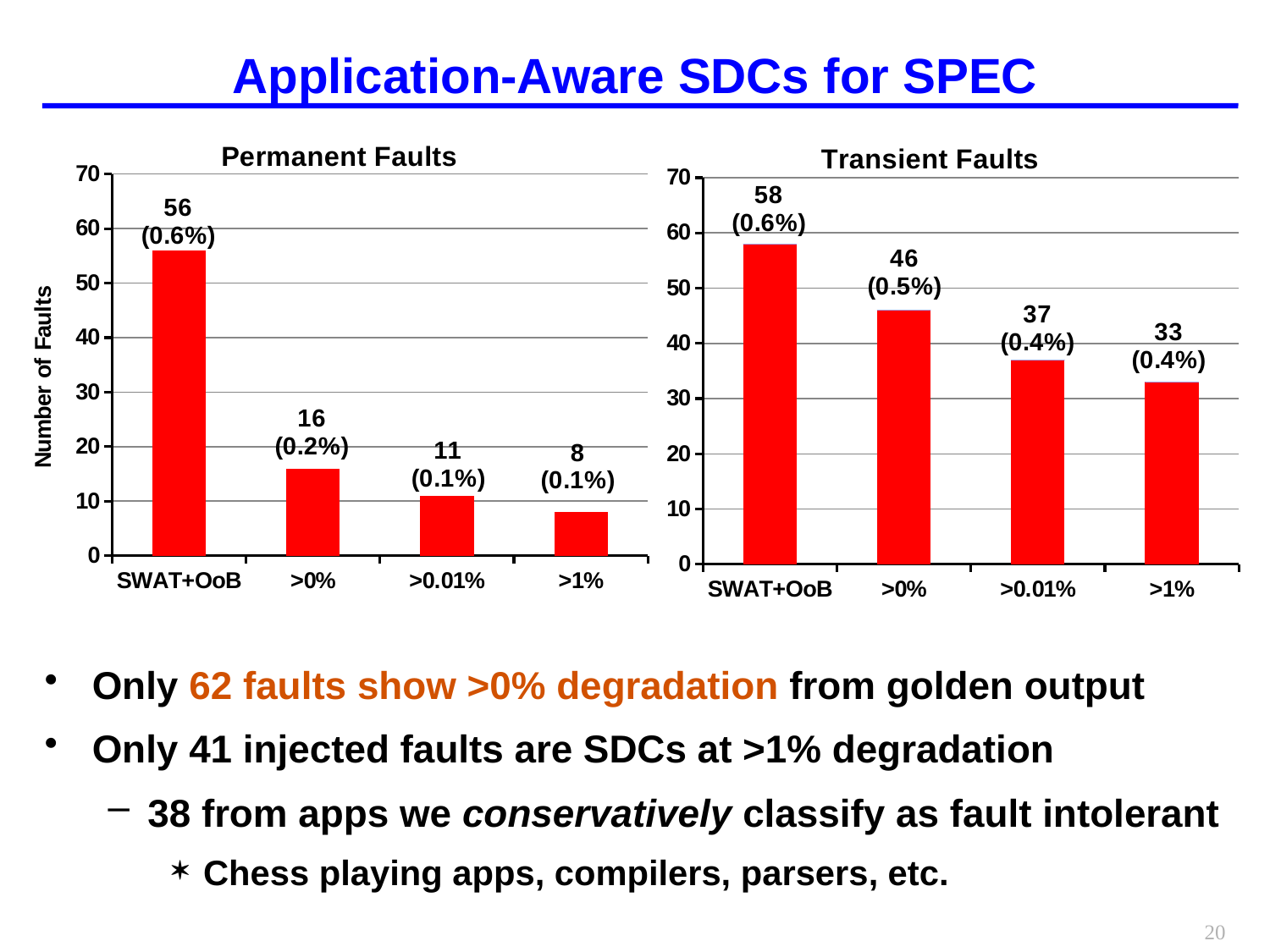
In the Permanent Faults chart, what is the number of faults for SWAT+OoB? 56 In the Transient Faults chart, do the values rise or fall from left to right along the x axis? fall In the Transient Faults chart, which category has the lowest number of faults? >1% In the Permanent Faults chart, what is the difference between the SWAT+OoB value and the >1% value? 48 What kind of chart is the Transient Faults chart? bar chart Which is larger: the >1% value in the Permanent Faults chart or the >1% value in the Transient Faults chart? Transient Faults In the Permanent Faults chart, which category has the highest number of faults? SWAT+OoB In the Transient Faults chart, what is the number of faults for >0.01%? 37 In the Permanent Faults chart, what percentage is shown in parentheses for the >0% bar? 0.2% How many categories are shown on the x axis of the Permanent Faults chart? 4 In the Transient Faults chart, is the value for >0% greater or less than 40? greater In the Transient Faults chart, what is the difference between the >0% value and the >0.01% value? 9